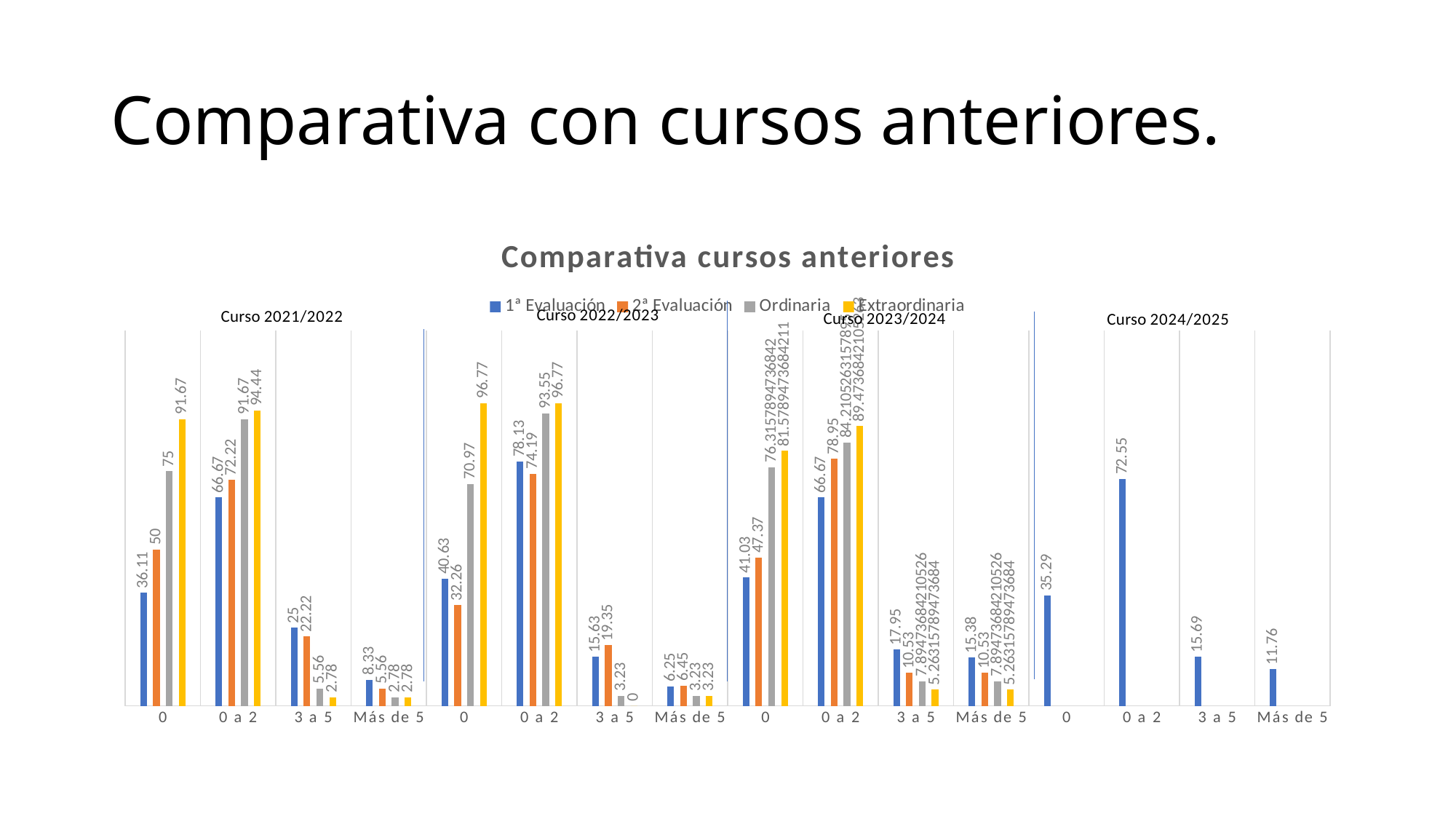
How many curso groups are shown along the x axis of the chart? 4 How many series does the chart legend list? 4 What is the value of 1ª Evaluación for category 0 in Curso 2021/2022? 36.11 What is the value of 1ª Evaluación for category 0 a 2 in Curso 2024/2025? 72.55 What is the title of the chart? Comparativa cursos anteriores What is the value of 2ª Evaluación for category 3 a 5 in Curso 2023/2024? 10.53 Within Curso 2021/2022, which series has the highest value for category 0 a 2? Extraordinaria What is the difference between the Ordinaria value (75) and the 2ª Evaluación value (50) for category 0 in Curso 2021/2022? 25 Within Curso 2024/2025, which category has the lowest 1ª Evaluación value? Más de 5 In Curso 2022/2023, which is larger for category 3 a 5: 1ª Evaluación or 2ª Evaluación? 2ª Evaluación What type of chart is shown on the slide? bar chart What is the value of Extraordinaria for category 0 a 2 in Curso 2022/2023? 96.77